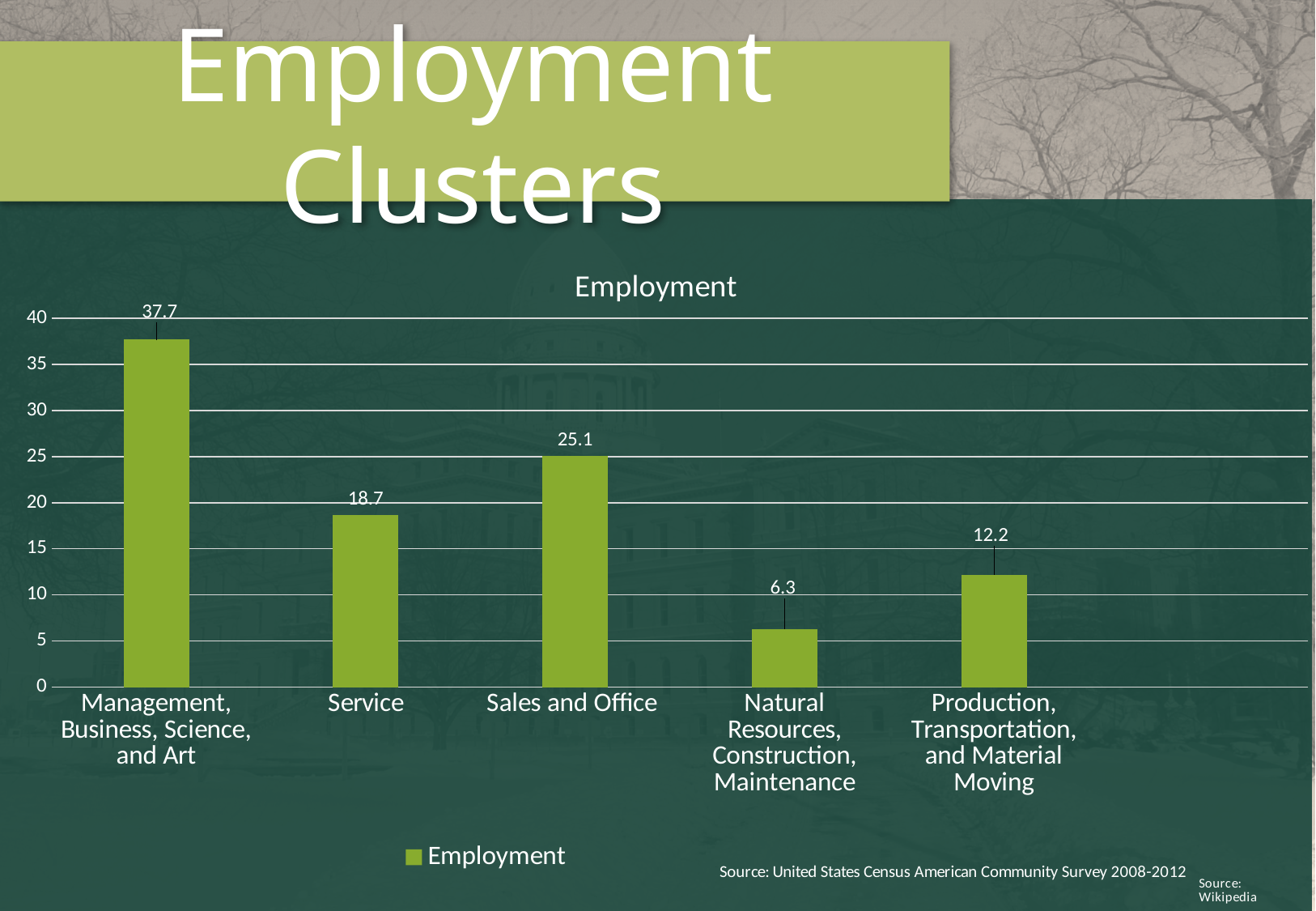
What is the value for Sales and Office? 25.1 What is the value for Service? 18.7 How many series does the legend list? 1 What is the difference between the values for Service and Production, Transportation, and Material Moving? 6.5 Which category has the lowest value? Natural Resources, Construction, Maintenance How many categories are shown on the x axis? 5 Which is larger, the value for Service or the value for Production, Transportation, and Material Moving? Service Which category has the highest value? Management, Business, Science, and Art What is the difference between the values for Management, Business, Science, and Art and Sales and Office? 12.6 What is the value for Natural Resources, Construction, Maintenance? 6.3 What kind of chart is shown on the slide? bar chart Is the value for Sales and Office greater or less than 20? greater